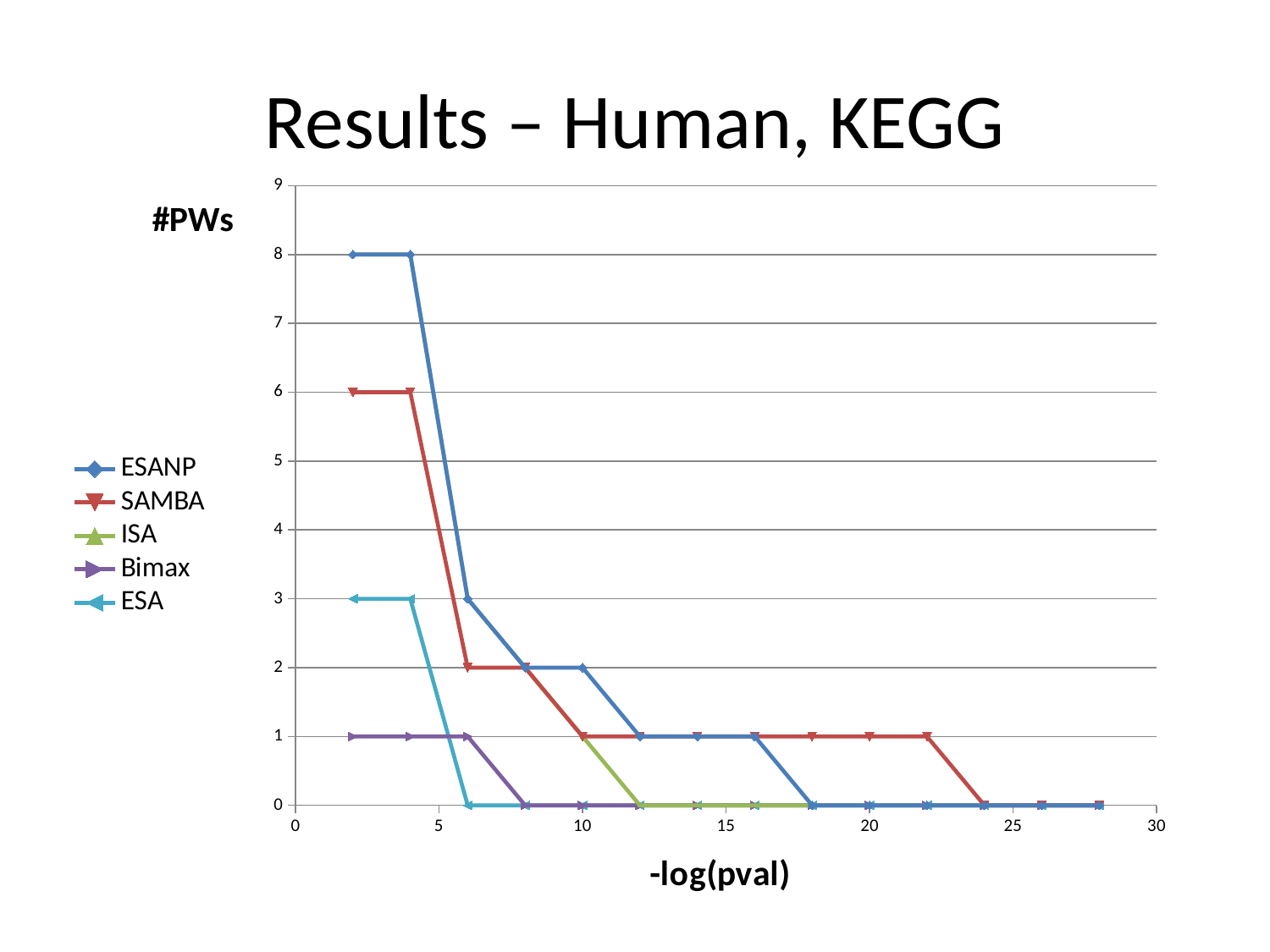
What is the value of ESANP at -log(pval) = 10? 2 What kind of chart is shown on the slide? line chart How many series does the legend list? 5 What is the value of ESANP at -log(pval) = 20? 0 What is the value of SAMBA at -log(pval) = 10? 1 At -log(pval) = 10, which is larger, ESANP or SAMBA? ESANP What is the highest #PWs value reached by the ESA series? 3 Do the ESANP values rise or fall as -log(pval) increases? fall What is the difference between the highest value of ESANP and the highest value of SAMBA? 2 What is the highest #PWs value reached by the ESANP series? 8 What is the highest #PWs value reached by the SAMBA series? 6